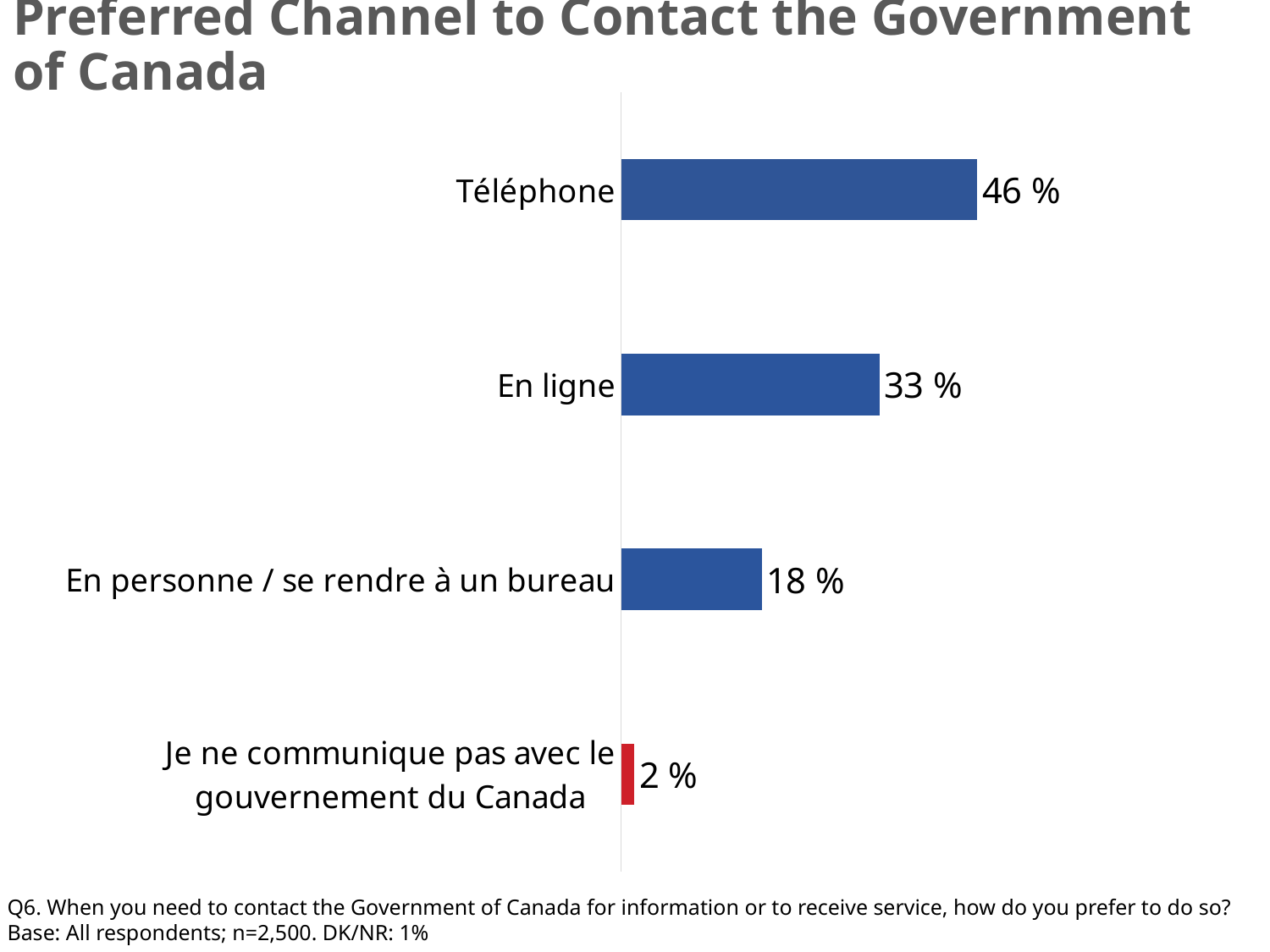
Which category has the highest value? Téléphone What is the value for Téléphone? 46 % Which is larger, the value for En ligne or the value for En personne / se rendre à un bureau? En ligne Which category has the lowest value? Je ne communique pas avec le gouvernement du Canada Which bar is coloured red rather than blue? Je ne communique pas avec le gouvernement du Canada What is the value for En personne / se rendre à un bureau? 18 % What kind of chart is shown on the slide? Bar chart What is the difference between the values for En ligne and En personne / se rendre à un bureau? 15 % What is the value for En ligne? 33 % What is the value for Je ne communique pas avec le gouvernement du Canada? 2 % What is the difference between the values for Téléphone and En ligne? 13 % How many categories are shown in the chart? 4